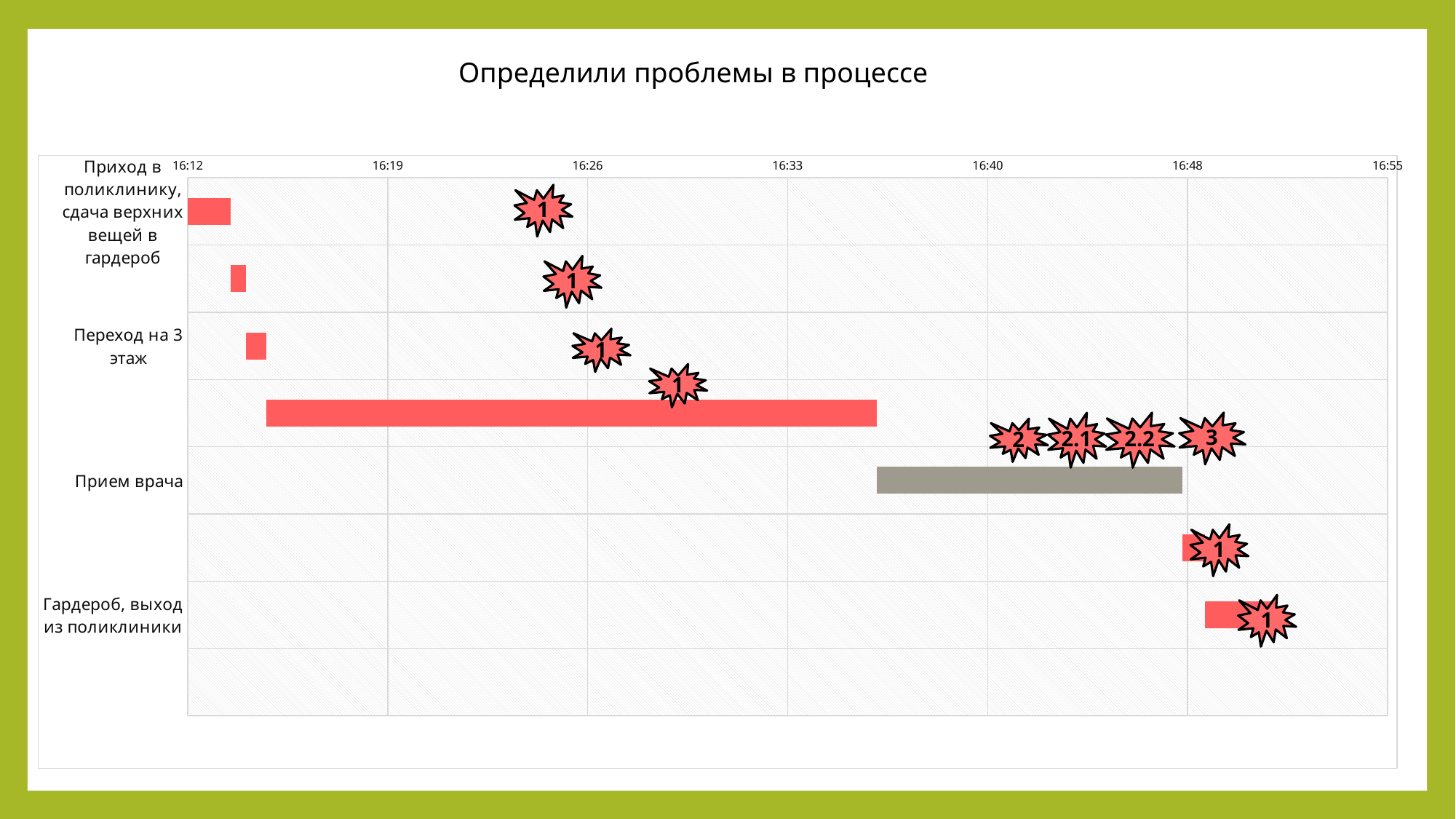
Does the longest red bar end before or after 16:40? before What kind of chart is shown on the slide? bar chart What is the last time label on the x axis? 16:55 Which is longer: the bar for Прием врача or the bar for Переход на 3 этаж? Прием врача How many starburst problem markers are placed on the chart? 10 What is the first time label on the x axis? 16:12 Does the bar for Гардероб, выход из поликлиники start before or after 16:48? after Which labelled stage has a grey bar instead of a red one? Прием врача Do the bars start progressively later as you move down the rows of the chart? yes What is the title of the chart? Определили проблемы в процессе How many bars are plotted on the chart? 7 Does the bar for Прием врача start before or after 16:33? after